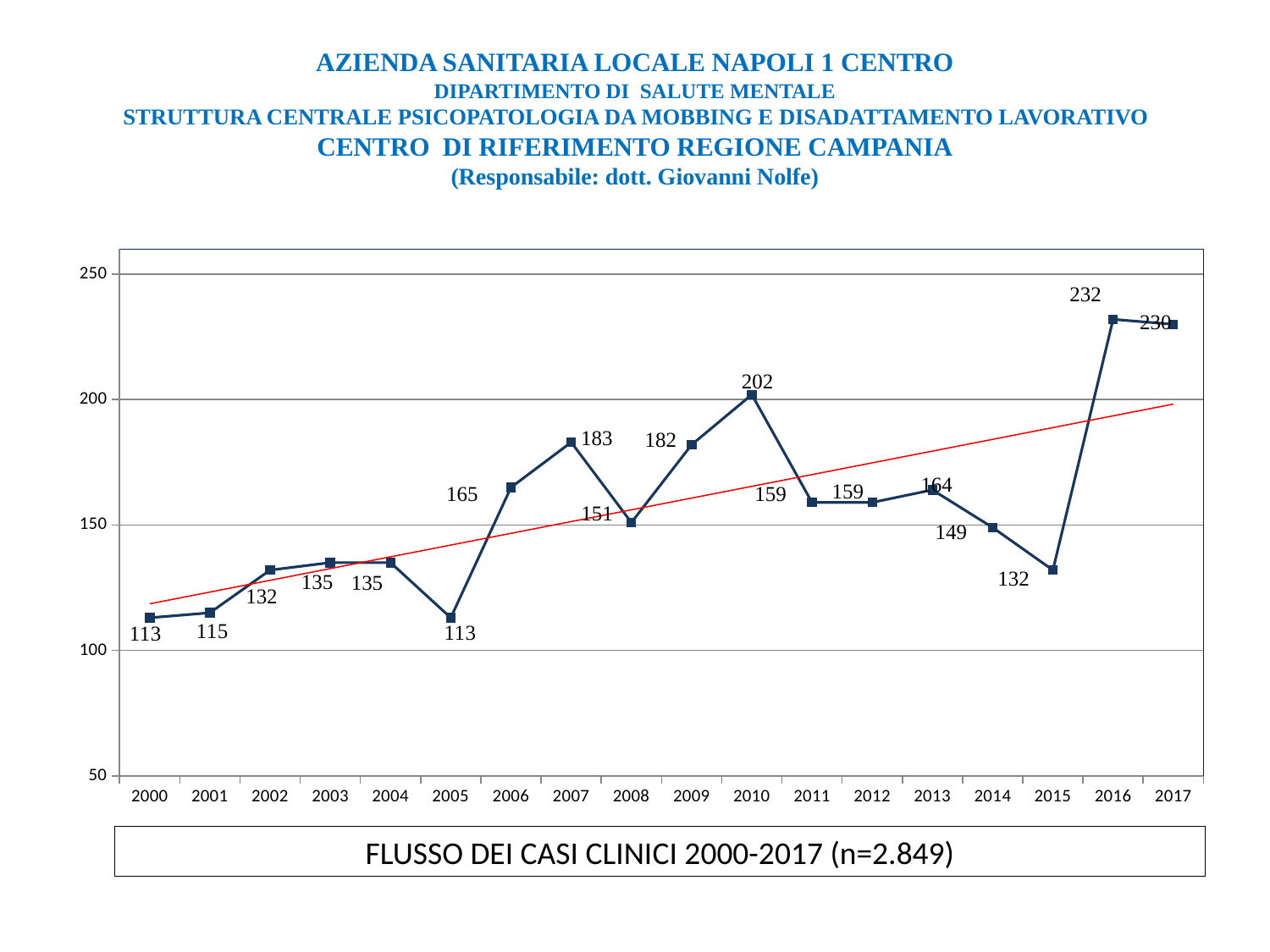
How many years are plotted on the chart? 18 What is the title shown below the chart? FLUSSO DEI CASI CLINICI 2000-2017 (n=2.849) What is the lowest value plotted on the chart? 113 What is the value for 2010? 202 What kind of chart is shown on the slide? line chart What is the difference between the values for 2016 and 2015? 100 Which is larger, the value for 2007 or the value for 2009? 2007 What is the value for 2016? 232 What is the difference between the values for 2010 and 2011? 43 Which year has the highest value? 2016 What is the value for 2005? 113 What is the value for 2014? 149